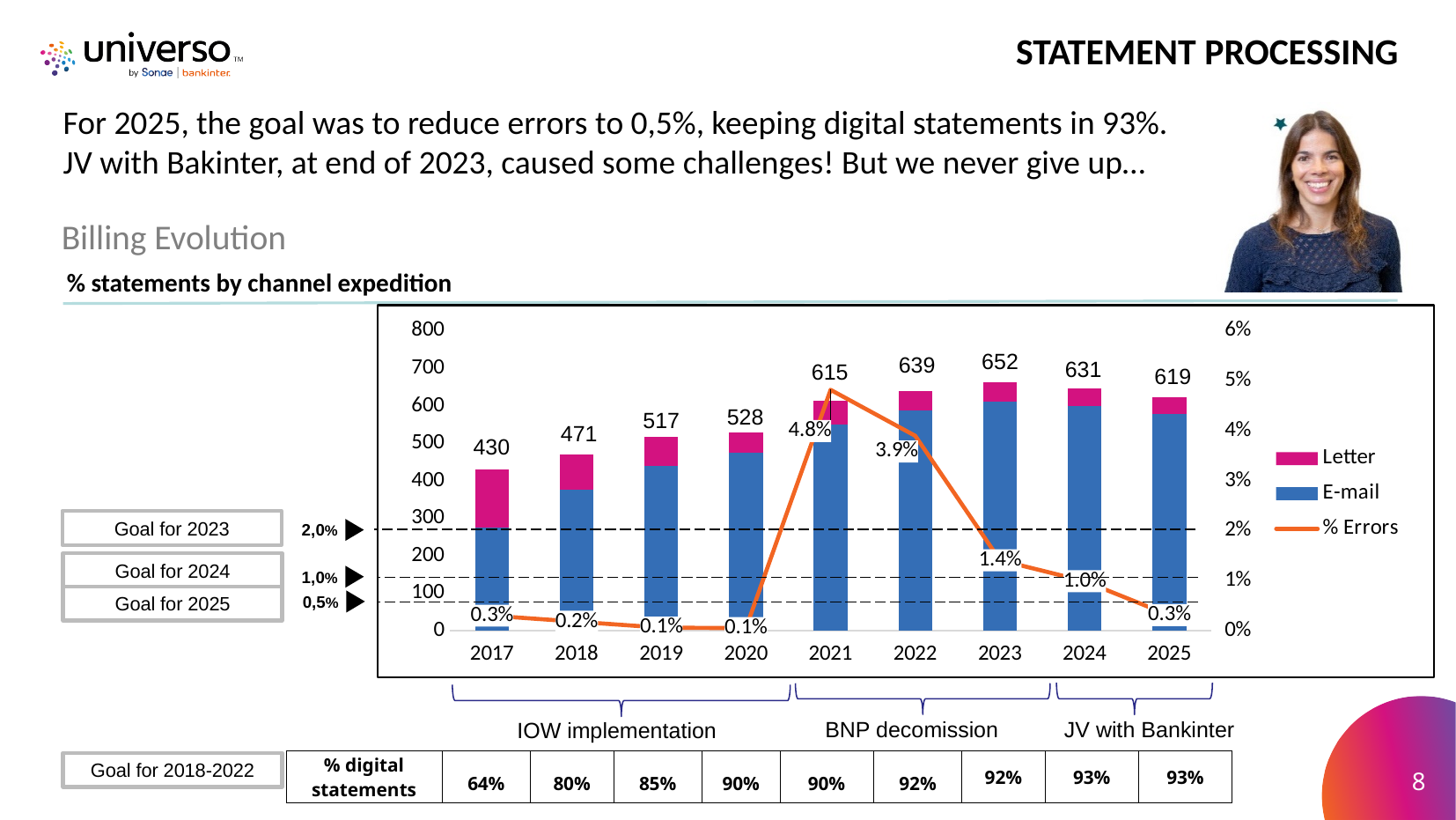
What is the difference between the total statements in 2023 and in 2017? 222 What is the % Errors value for 2022? 3.9% What is the total number of statements shown for 2021? 615 Is the total number of statements for 2018 greater or less than 500? less In which year is the % Errors value highest? 2021 How many series does the chart legend list? 3 Which year has a larger total of statements, 2022 or 2025? 2022 Which year has the lowest total number of statements? 2017 What kind of chart is used to show the statements by channel? Stacked bar chart with a line Does the % Errors line rise or fall from 2021 to 2025? fall How many years are shown on the x axis of the chart? 9 Which year has the highest total number of statements? 2023